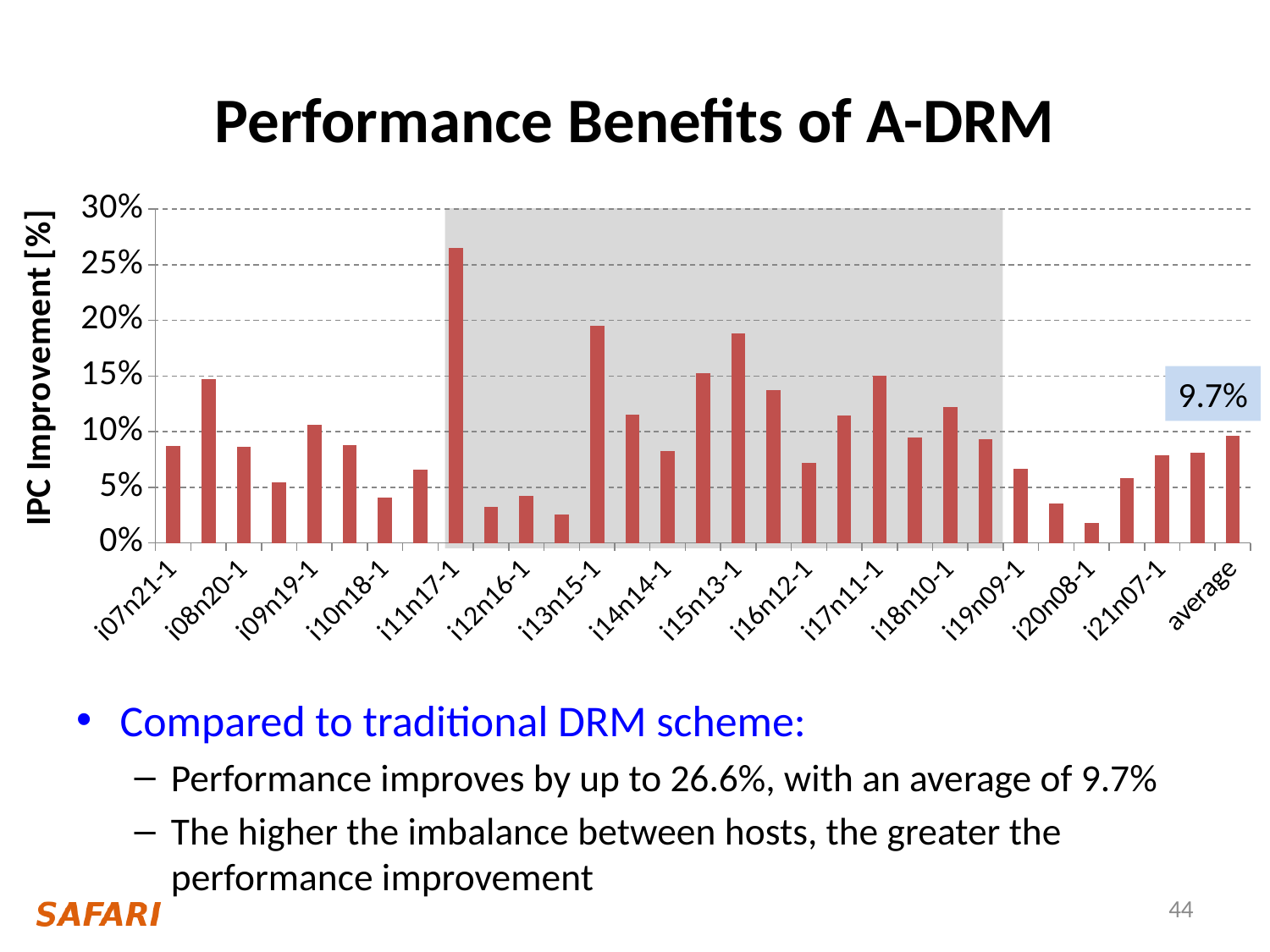
What type of chart is shown on the slide? bar chart Which has a higher IPC improvement, i13n15-1 or i14n14-1? i13n15-1 Is the value for i13n15-1 greater or less than 15%? greater What is the highest value shown on the y-axis? 30% Is the value for i20n08-1 greater or less than 5%? less What is the label of the y-axis? IPC Improvement [%] Is the value for i08n20-1 greater or less than 10%? less Which category has the highest IPC improvement? i11n17-1 What is the IPC improvement value shown for the 'average' bar? 9.7%